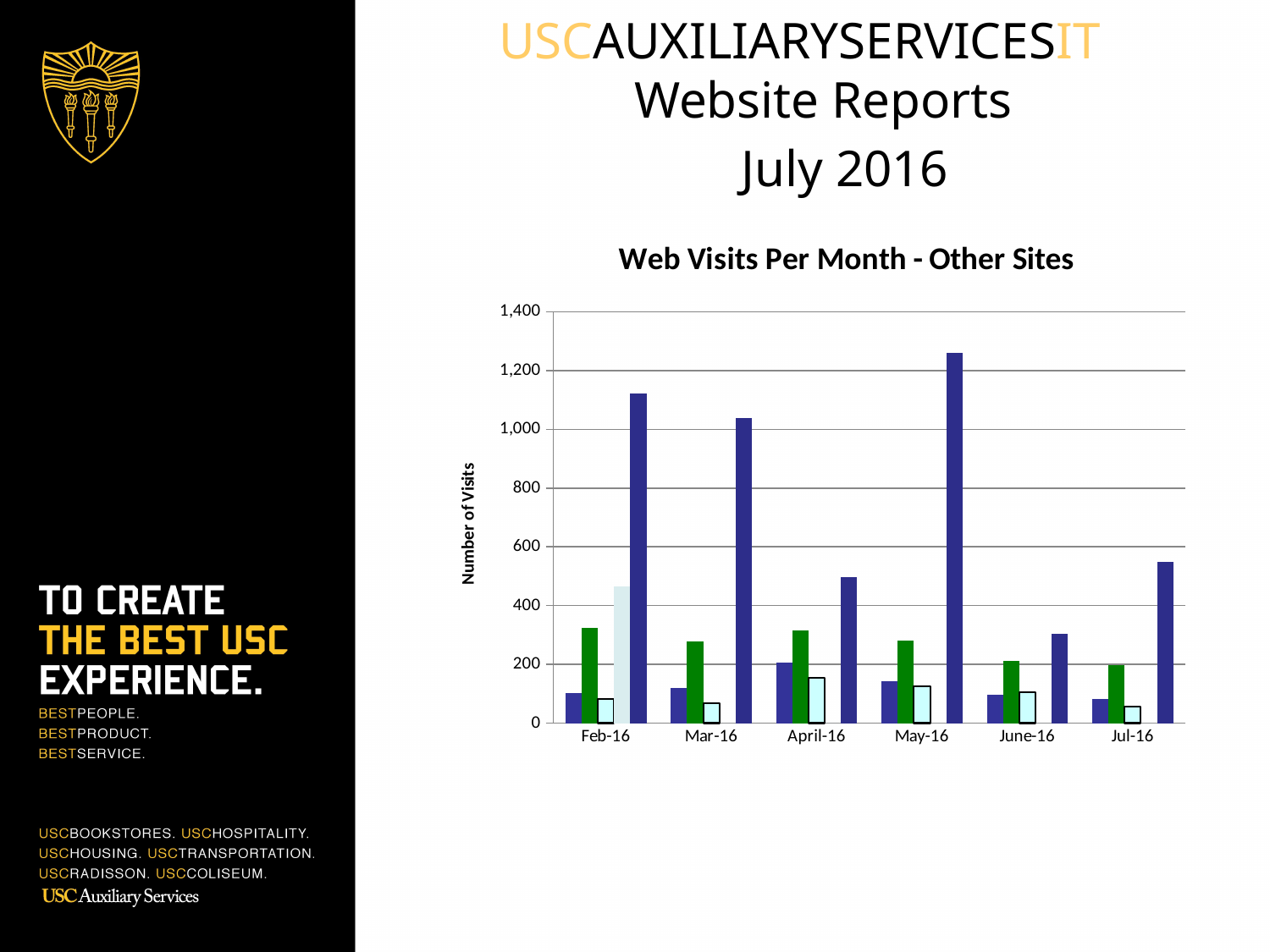
In which month does the tallest bar in the chart appear? May-16 Is the tallest bar for Jul-16 greater or less than 600? less Is the tallest bar for June-16 greater or less than 400? less Which month has the lowest tallest bar in the chart? June-16 How many months are shown on the x axis of the chart? 6 What type of chart is shown on the slide? bar chart What is the title of the chart? Web Visits Per Month - Other Sites Which month has the tallest bar: Feb-16 or Mar-16? Feb-16 Is the tallest bar for Feb-16 greater or less than 1,000? greater What is the label on the vertical axis of the chart? Number of Visits